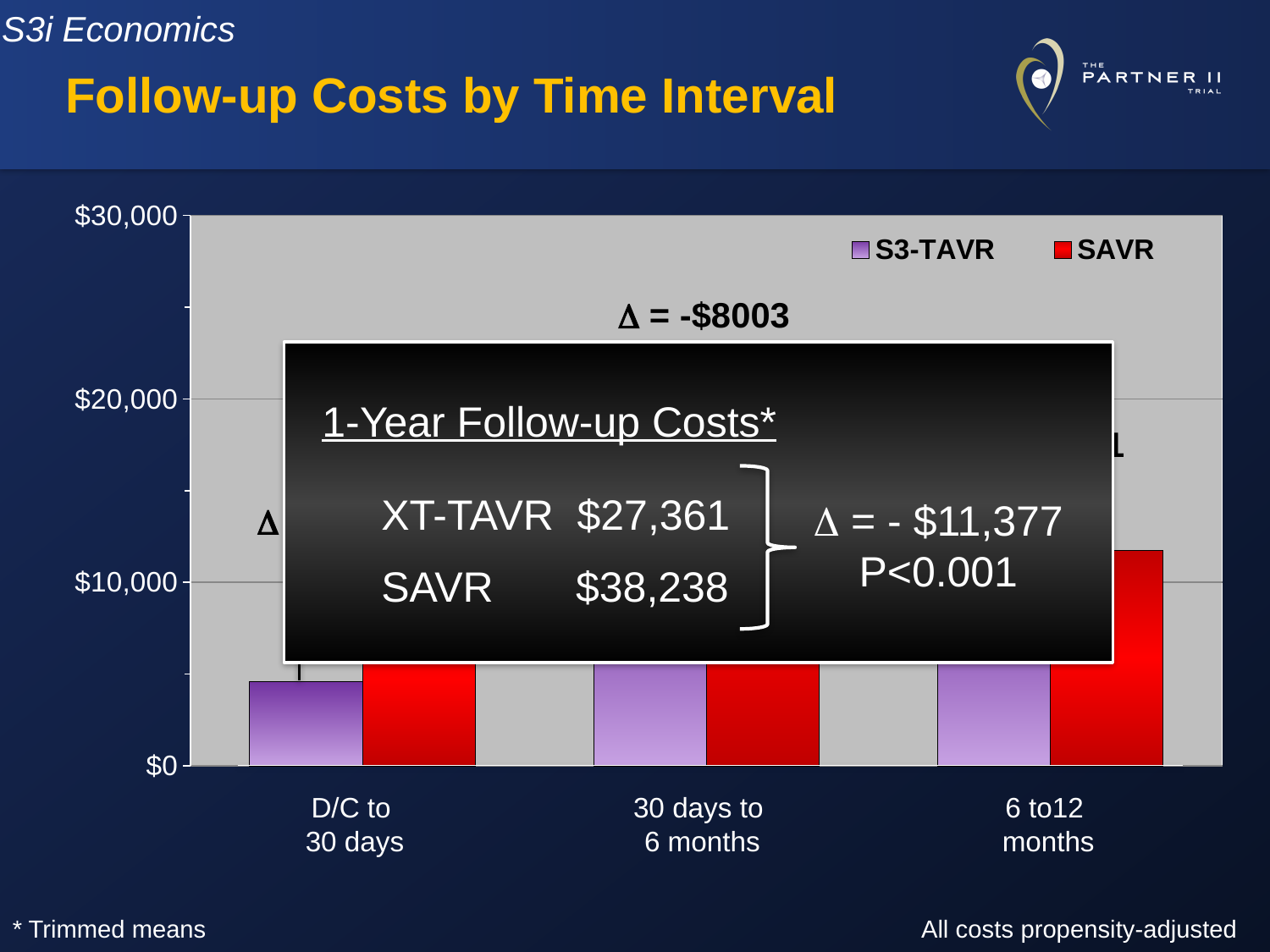
What Δ value is printed above the 30 days to 6 months interval? -$8003 What are the two series named in the chart legend? S3-TAVR and SAVR What kind of chart is shown on the slide? bar chart Is the S3-TAVR value for D/C to 30 days greater or less than $10,000? less Is the SAVR value for 6 to 12 months greater or less than $10,000? greater How many series does the chart legend list? 2 For the D/C to 30 days interval, which series has the larger value, S3-TAVR or SAVR? SAVR What is the title of the chart? Follow-up Costs by Time Interval According to the 1-Year Follow-up Costs box, what is the cost for SAVR? $38,238 How many time intervals are shown on the x axis of the chart? 3 According to the 1-Year Follow-up Costs box, what is the cost for XT-TAVR? $27,361 What is the Δ between XT-TAVR and SAVR 1-year follow-up costs shown in the box? -$11,377